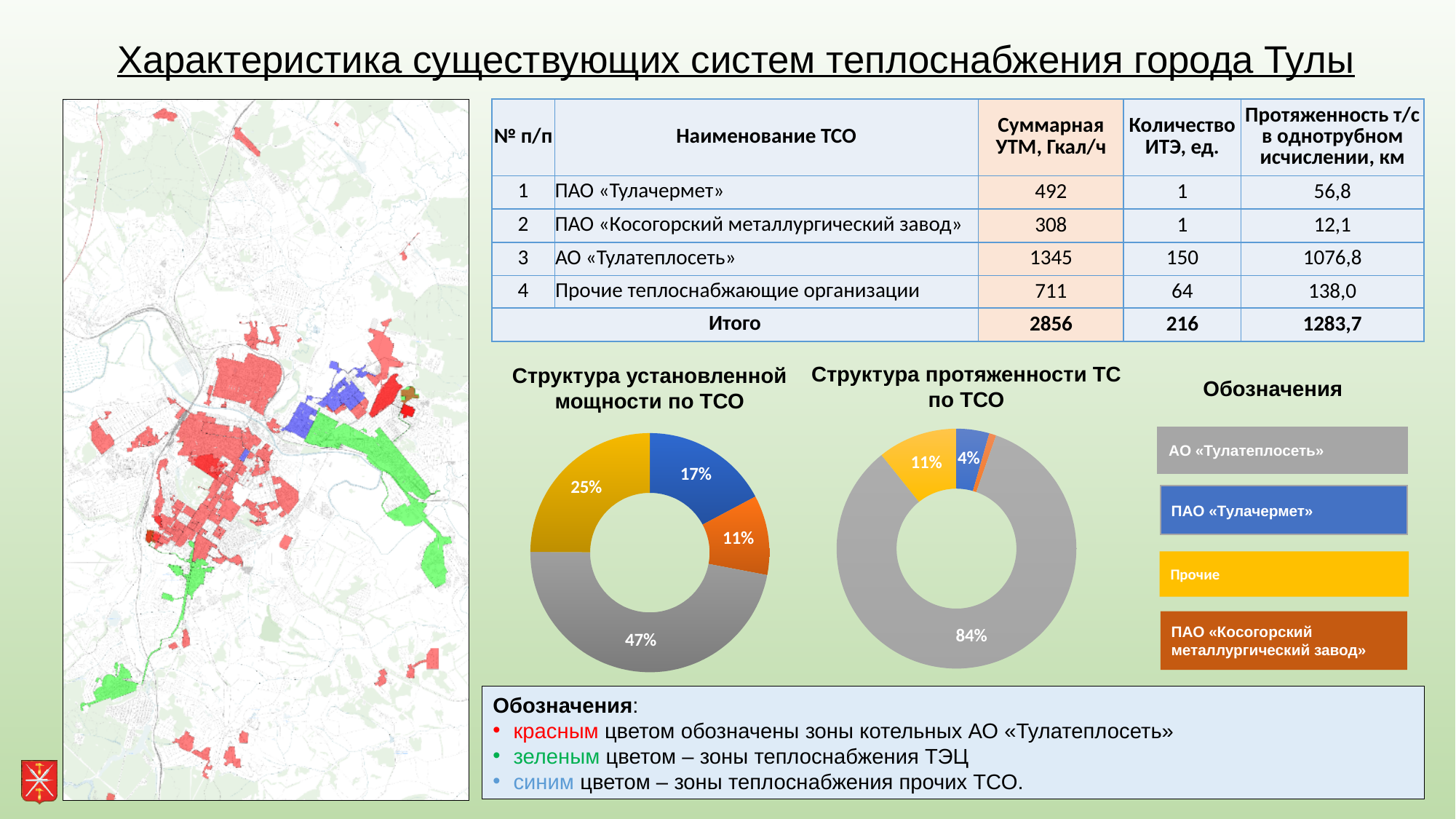
In the chart 'Структура протяженности ТС по ТСО', what share is shown for ПАО «Тулачермет» (blue slice)? 4% In the chart 'Структура установленной мощности по ТСО', what share is shown for АО «Тулатеплосеть» (grey slice)? 47% In the chart 'Структура установленной мощности по ТСО', what is the difference in percentage points between the shares of АО «Тулатеплосеть» and Прочие? 22 In the chart 'Структура протяженности ТС по ТСО', what share is shown for АО «Тулатеплосеть» (grey slice)? 84% In the chart 'Структура установленной мощности по ТСО', what share is shown for ПАО «Тулачермет» (blue slice)? 17% How many organisations are listed in the 'Обозначения' legend next to the charts? 4 In the chart 'Структура установленной мощности по ТСО', which organisation has the largest share? АО «Тулатеплосеть» What type of chart is 'Структура протяженности ТС по ТСО'? Doughnut (pie) chart In the chart 'Структура установленной мощности по ТСО', which organisation has the smallest share? ПАО «Косогорский металлургический завод» In the chart 'Структура протяженности ТС по ТСО', what share is shown for Прочие (yellow slice)? 11% In the chart 'Структура установленной мощности по ТСО', what share is shown for ПАО «Косогорский металлургический завод» (orange slice)? 11% In the chart 'Структура установленной мощности по ТСО', what share is shown for Прочие (yellow slice)? 25%